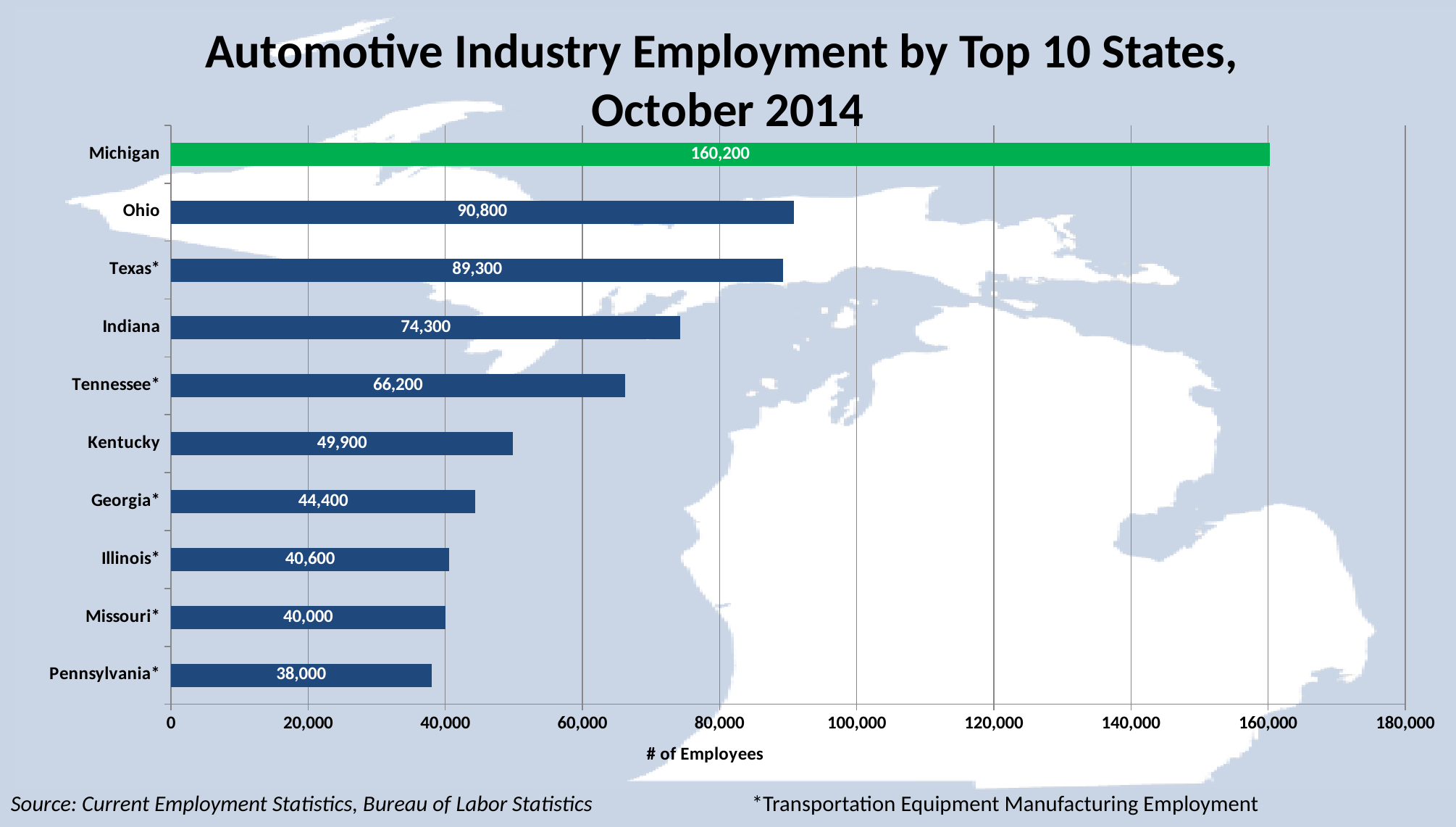
What is the difference in employees between Indiana and Tennessee*? 8,100 Which has more employees, Georgia* or Illinois*? Georgia* What is the number of employees for Michigan? 160,200 How many states are shown in the chart? 10 What is the number of employees for Pennsylvania*? 38,000 Is the value for Texas* greater or less than 80,000? greater What is the label of the horizontal axis? # of Employees What is the number of employees for Kentucky? 49,900 Which state has the lowest automotive industry employment? Pennsylvania* Which state has the highest automotive industry employment? Michigan What is the difference in employees between Michigan and Ohio? 69,400 What kind of chart is shown on the slide? bar chart